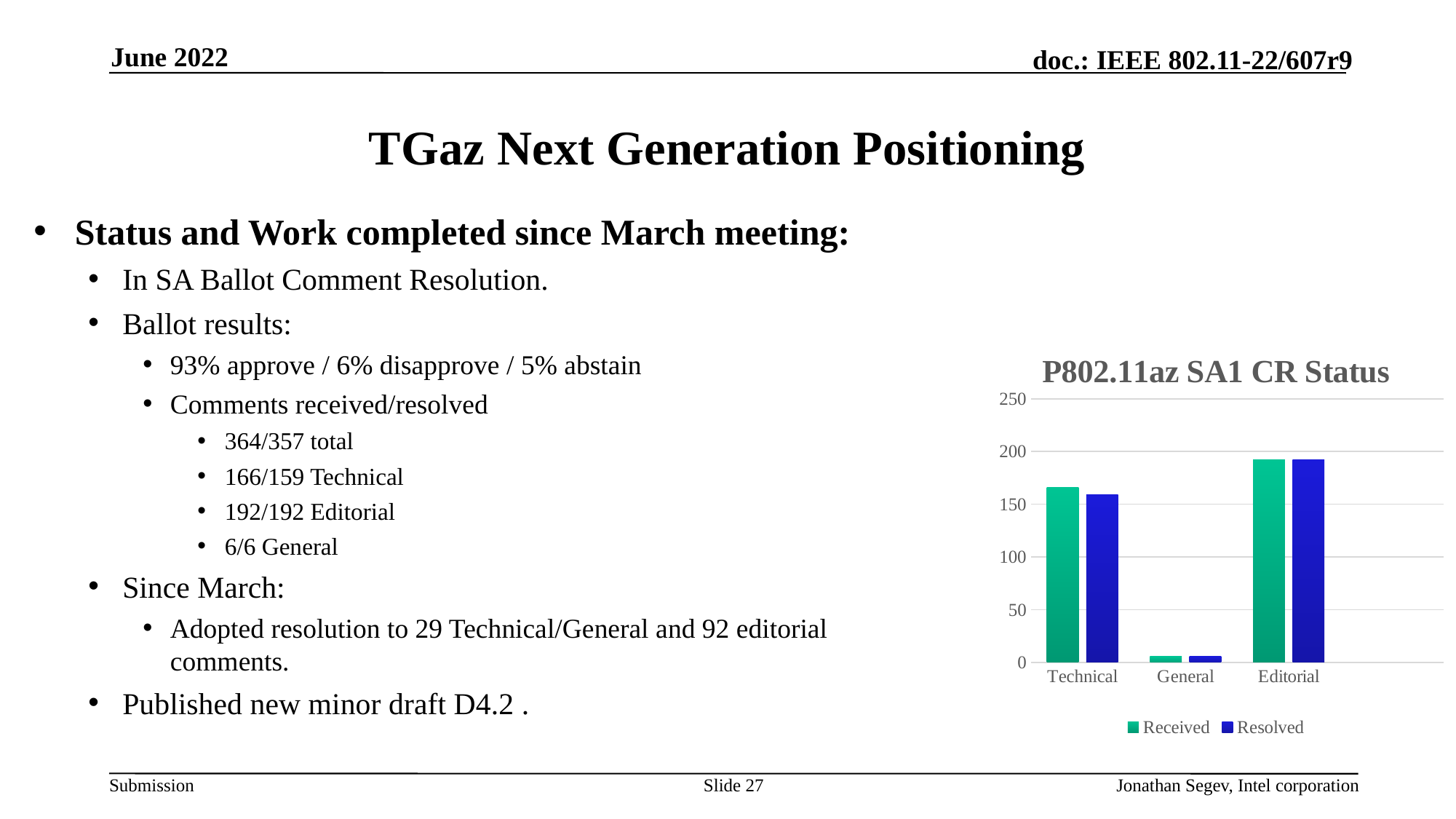
Which is larger, the Received value for Editorial or the Received value for Technical? Editorial How many categories are shown on the x axis of the chart? 3 Which series is shown in blue in the chart? Resolved How many series does the chart legend list? 2 What is the title of the chart? P802.11az SA1 CR Status Is the Resolved value for General greater or less than 50? less Is the Received value for Technical greater or less than 150? greater Is the Received value for Editorial greater or less than 200? less What kind of chart is shown on the slide? bar chart Which category has the highest Received value? Editorial Which category has the lowest Resolved value? General